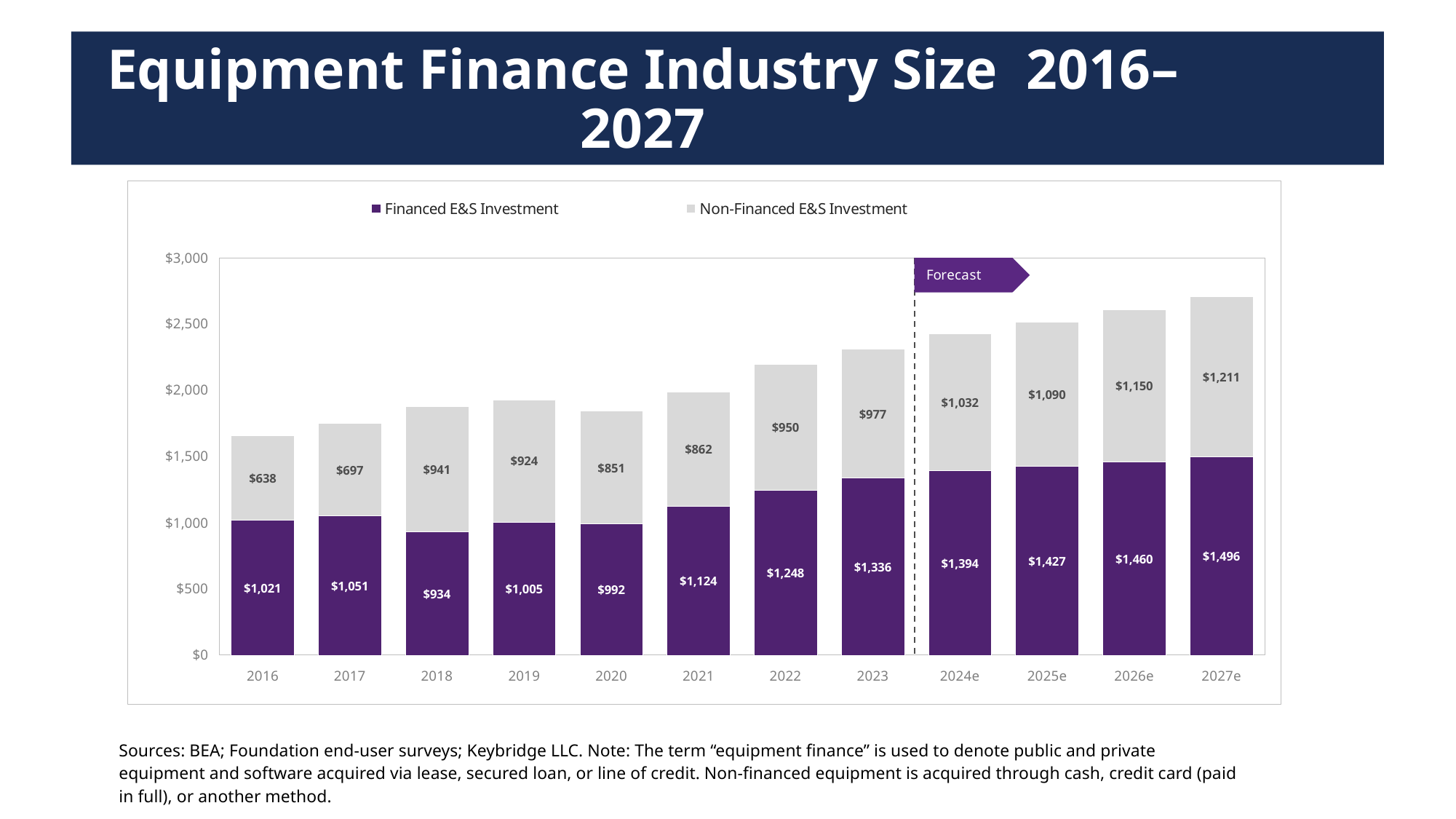
What is the Non-Financed E&S Investment value for 2023? $977 What kind of chart is shown on the slide? Stacked bar chart How many series does the legend list? 2 What is the difference between the Financed E&S Investment values for 2027e and 2016? $475 Which is larger in 2018: Financed E&S Investment or Non-Financed E&S Investment? Non-Financed E&S Investment Which year has the highest Financed E&S Investment value? 2027e What is the Financed E&S Investment value for 2016? $1,021 Which year has the lowest Non-Financed E&S Investment value? 2016 How many years are shown on the x axis? 12 What label appears in the purple arrow box above the dashed line? Forecast Is the total height of the 2016 bar greater or less than $2,000? less What is the total of the stacked bar for 2027e? $2,707